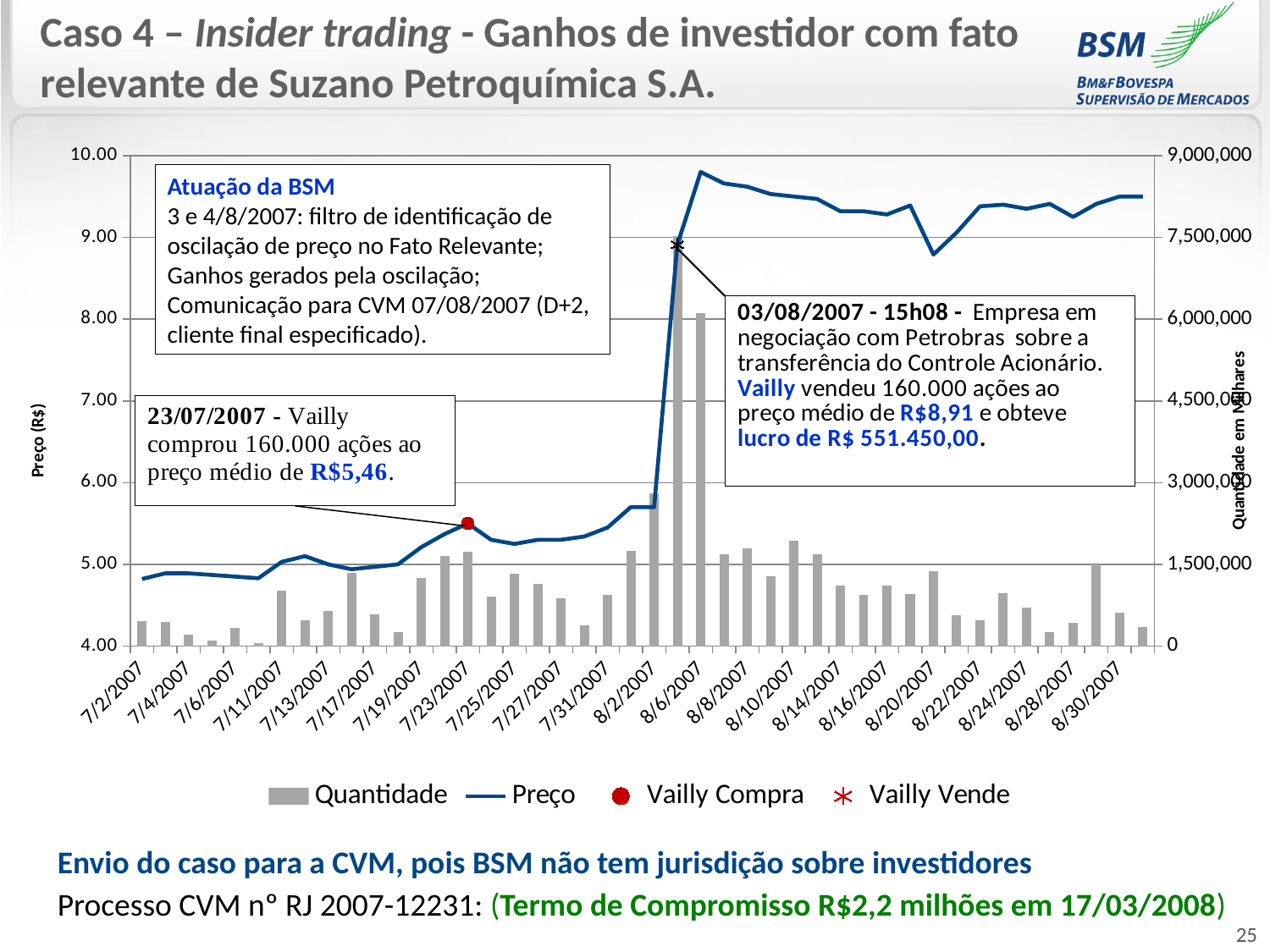
What is the title of the left vertical axis of the chart? Preço (R$) Is the Preço value at the Vailly Compra marker (23/07/2007) greater or less than 6.00? less Does the Preço line rise or fall between 7/31/2007 and 8/6/2007? rise What kind of chart is shown on the slide? A combined bar and line chart Which is higher, the Preço on 7/2/2007 or the Preço on 8/30/2007? 8/30/2007 How many series does the chart legend list? 4 Is the Preço value on 7/2/2007 greater or less than 5.00? less Which is larger, the Quantidade bar on 7/2/2007 or the Quantidade bar on 8/6/2007? 8/6/2007 Is the tallest Quantidade bar greater or less than 6,000,000? greater Which series in the chart is plotted as bars? Quantidade